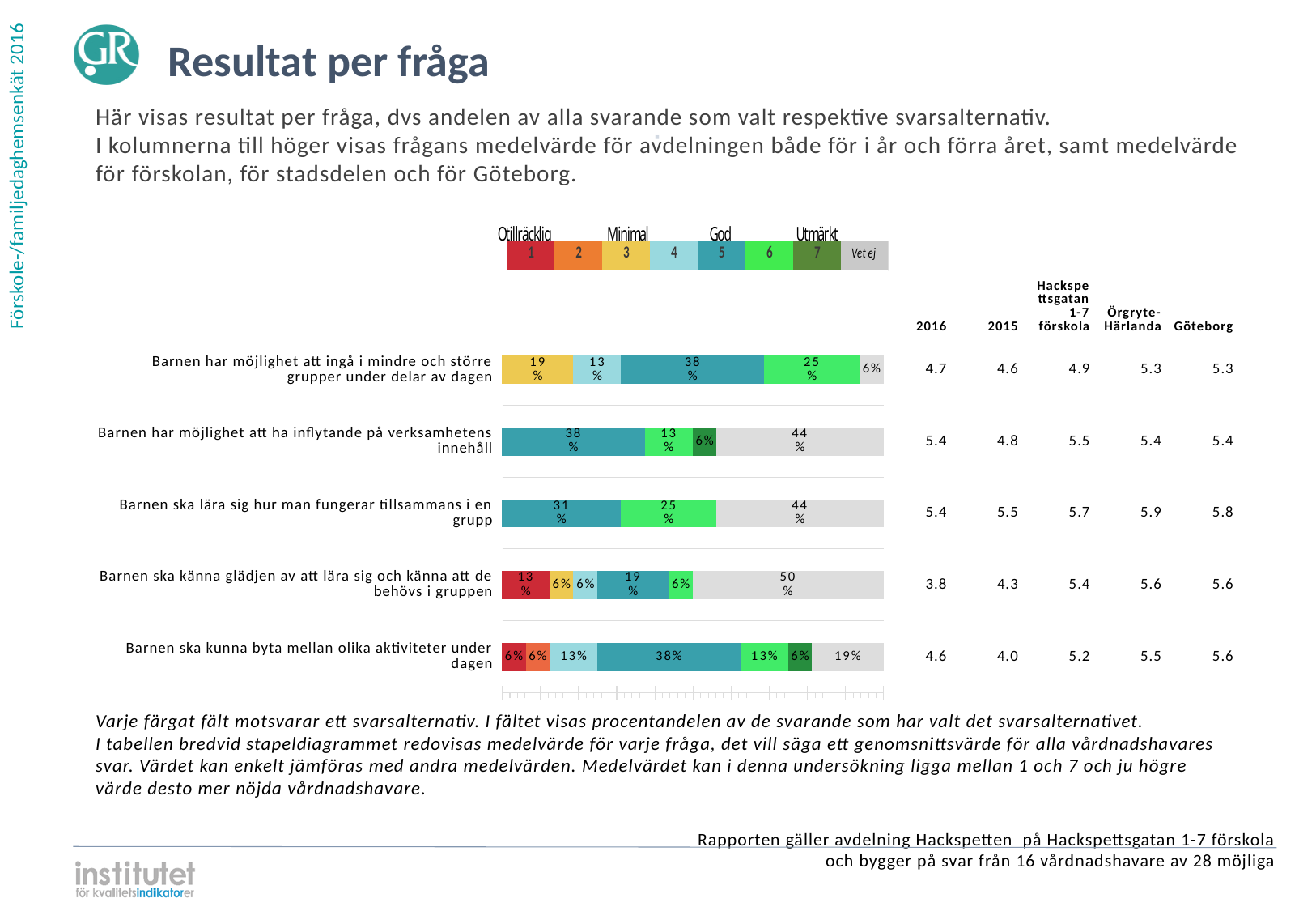
What label does the legend give to response option 7? Utmärkt What percentage chose 'Vet ej' for 'Barnen ska känna glädjen av att lära sig och känna att de behövs i gruppen'? 50% How many questions (categories) are shown in the bar chart? 5 What percentage of respondents chose option 5 (God) for 'Barnen har möjlighet att ingå i mindre och större grupper under delar av dagen'? 38% For 'Barnen har möjlighet att ha inflytande på verksamhetens innehåll', which is larger: the share for option 5 or the share for 'Vet ej'? Vet ej What is the difference between the option 5 share (38%) and the option 6 share (13%) for 'Barnen ska kunna byta mellan olika aktiviteter under dagen'? 25% What percentage chose option 6 for 'Barnen ska lära sig hur man fungerar tillsammans i en grupp'? 25% What is the 2016 mean value for 'Barnen ska känna glädjen av att lära sig och känna att de behövs i gruppen'? 3.8 What kind of chart is used to show the results per question? Stacked bar chart Which question has the largest 'Vet ej' share? Barnen ska känna glädjen av att lära sig och känna att de behövs i gruppen How many response options does the legend above the chart list? 8 What percentage chose option 1 (Otillräcklig) for 'Barnen ska känna glädjen av att lära sig och känna att de behövs i gruppen'? 13%